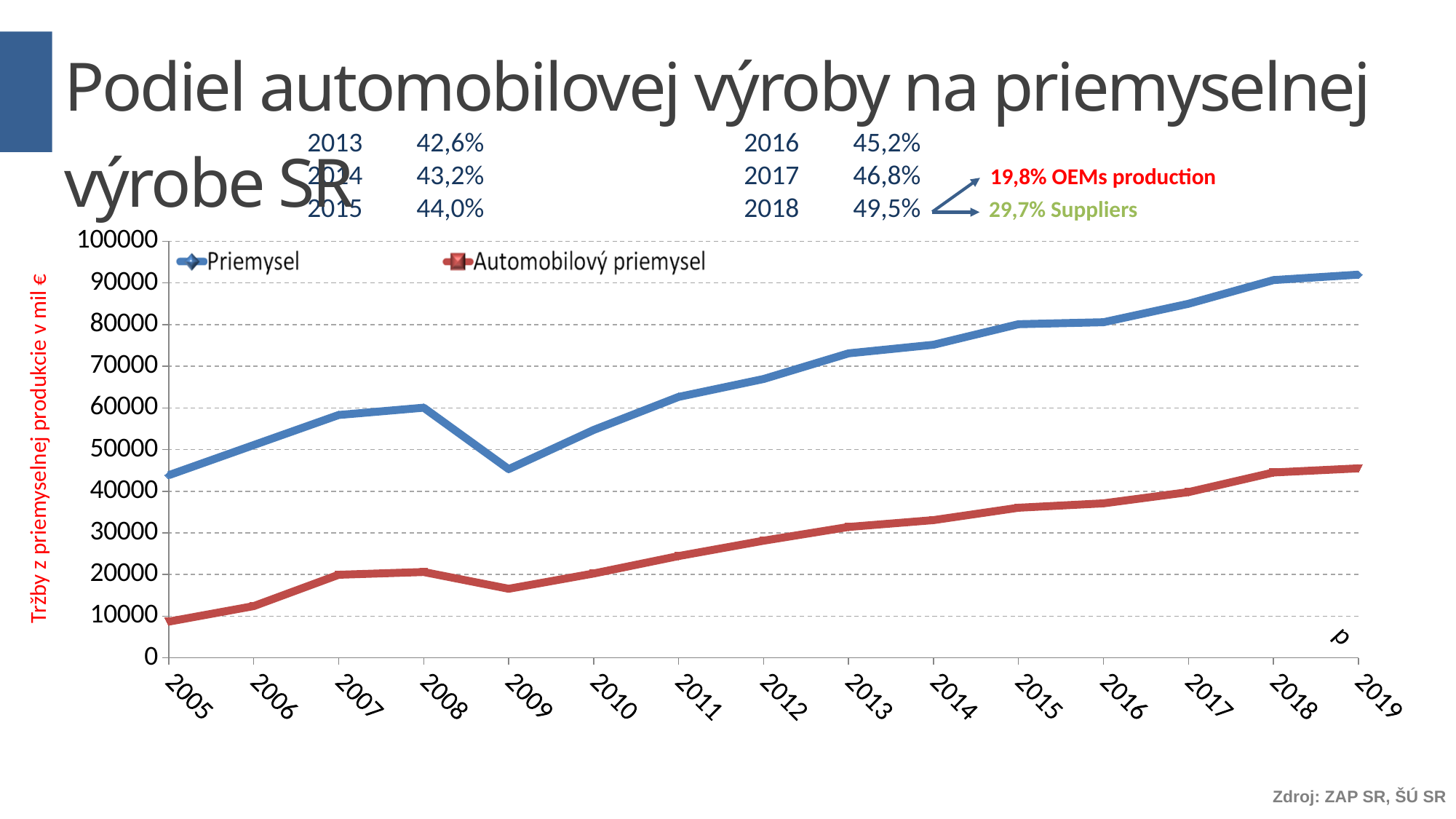
Is the value for Automobilový priemysel in 2019 greater or less than 40000? greater What is the label of the vertical axis of the chart? Tržby z priemyselnej produkcie v mil € What kind of chart is shown on the slide? line chart In which year does the Automobilový priemysel series have its lowest value? 2005 How many series does the chart legend list? 2 In which year does the Priemysel series reach its highest value? 2019 Which is larger for Priemysel: the value in 2008 or the value in 2009? 2008 What are the two series named in the chart legend? Priemysel and Automobilový priemysel How many years are plotted along the x axis of the chart? 15 Is the value for Priemysel in 2019 greater or less than 90000? greater Is the value for Priemysel in 2009 greater or less than 50000? less